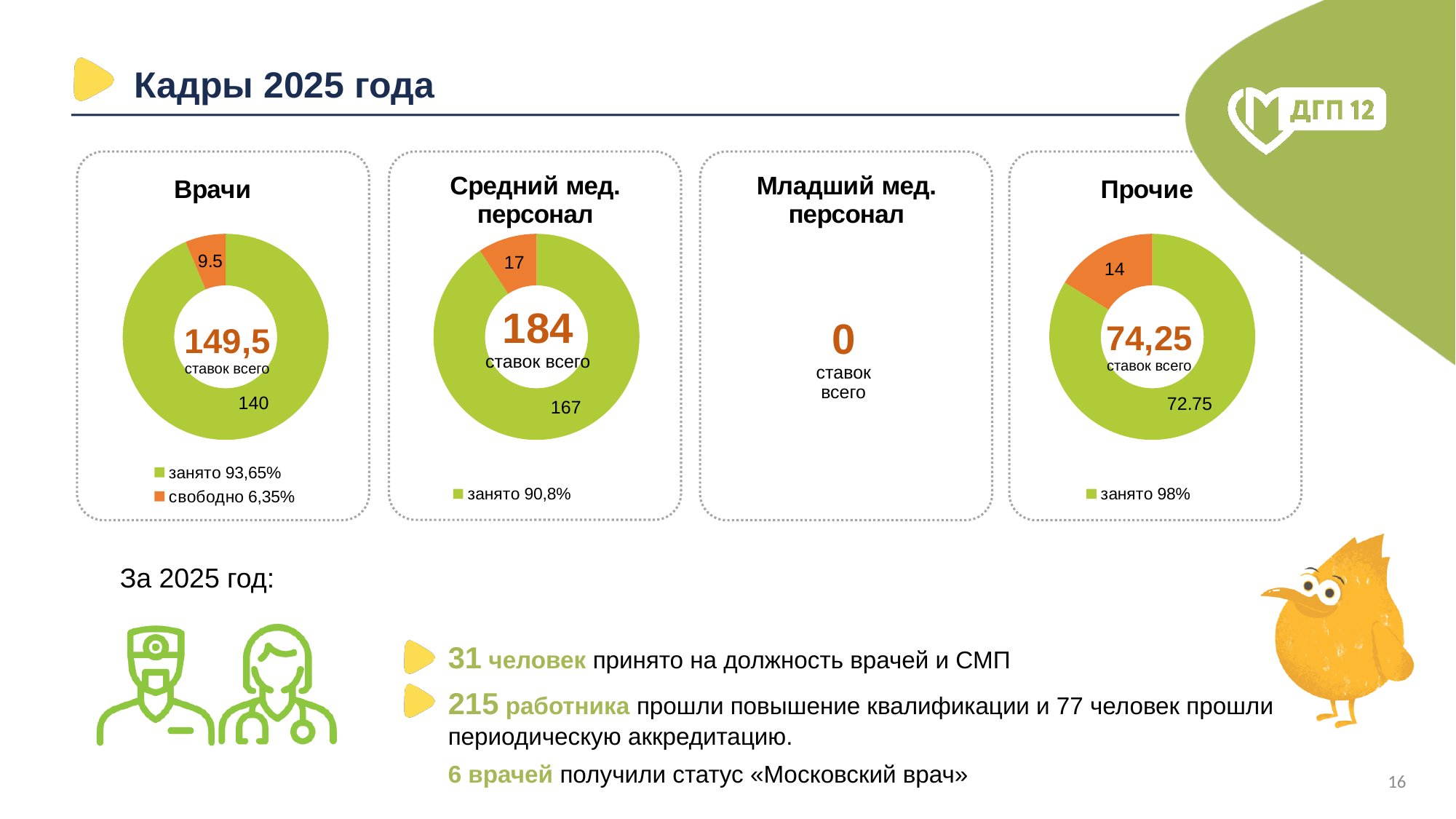
In the 'Средний мед. персонал' chart, what is the difference between the green slice value and the orange slice value? 150 What kind of chart is used in the 'Врачи' panel? donut (pie) chart In the 'Врачи' chart, what value is shown for the green (занято) slice? 140 In the 'Врачи' chart, what value is shown for the orange (свободно) slice? 9.5 In the 'Средний мед. персонал' chart, what value is shown for the orange slice? 17 In the 'Средний мед. персонал' chart, what value is shown for the green slice? 167 What percentage does the legend of the 'Прочие' chart give for 'занято'? 98% In the 'Прочие' chart, what value is shown for the orange slice? 14 In the 'Прочие' chart, what value is shown for the green slice? 72.75 What total number of positions (ставок всего) is shown in the centre of the 'Врачи' chart? 149,5 What total number of positions (ставок всего) is shown in the centre of the 'Средний мед. персонал' chart? 184 In the 'Врачи' chart, which slice is larger, the green one or the orange one? green